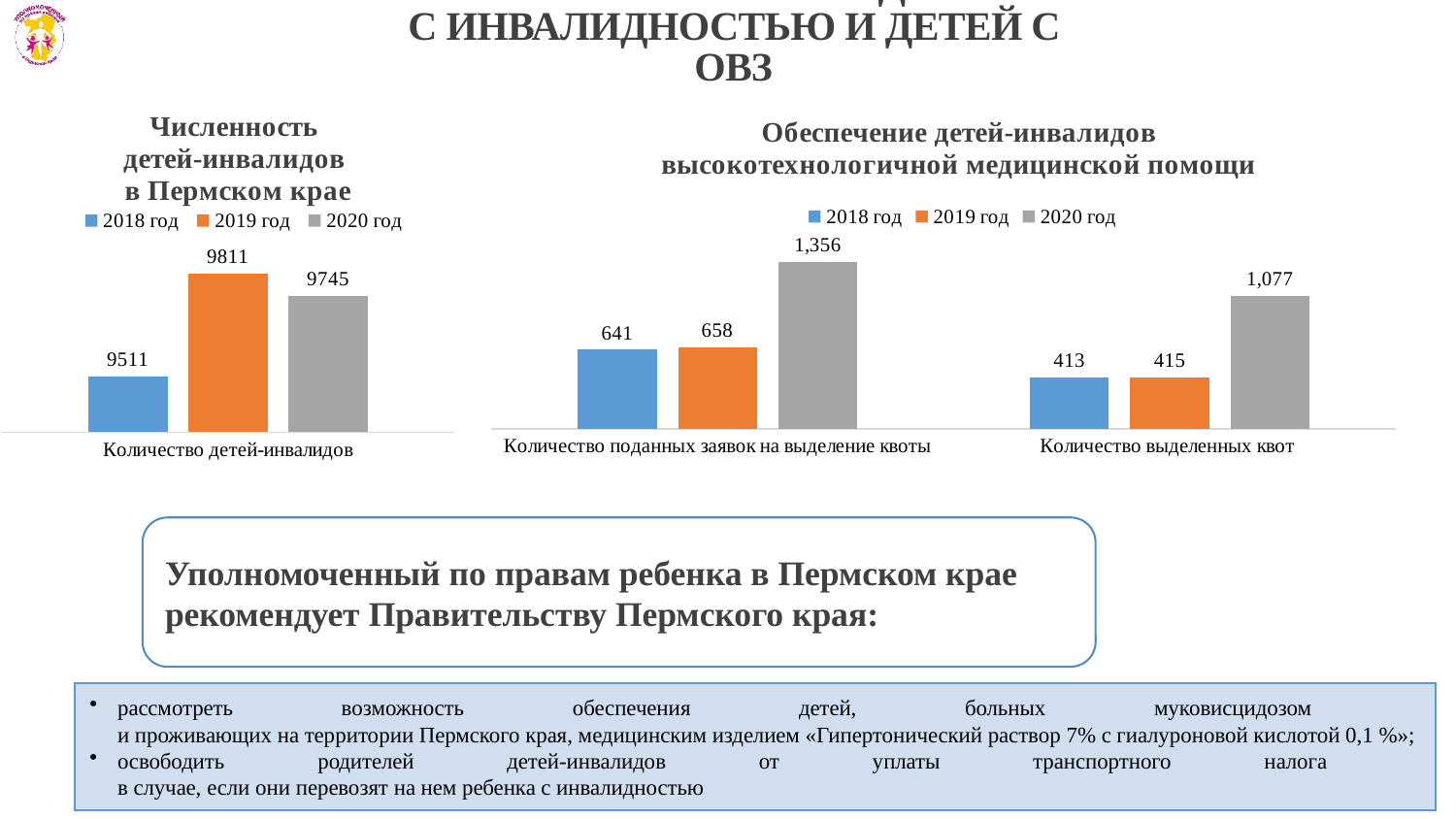
In the chart 'Численность детей-инвалидов в Пермском крае', what is the difference between the 2019 год and 2018 год values? 300 In the chart 'Обеспечение детей-инвалидов высокотехнологичной медицинской помощи', which is larger: the 2019 год value for 'Количество поданных заявок на выделение квоты' or the 2020 год value for 'Количество выделенных квот'? 2020 год value for 'Количество выделенных квот' In the chart 'Обеспечение детей-инвалидов высокотехнологичной медицинской помощи', what is the value for 2018 год in 'Количество выделенных квот'? 413 In the chart 'Обеспечение детей-инвалидов высокотехнологичной медицинской помощи', how many categories are shown on the x axis? 2 In the chart 'Численность детей-инвалидов в Пермском крае', which year has the lowest value? 2018 год What kind of chart is 'Обеспечение детей-инвалидов высокотехнологичной медицинской помощи'? Bar chart In the chart 'Обеспечение детей-инвалидов высокотехнологичной медицинской помощи', which year has the highest value for 'Количество выделенных квот'? 2020 год In the chart 'Обеспечение детей-инвалидов высокотехнологичной медицинской помощи', what is the value for 2020 год in 'Количество поданных заявок на выделение квоты'? 1,356 In the chart 'Обеспечение детей-инвалидов высокотехнологичной медицинской помощи', what is the difference between the 2020 год values for 'Количество поданных заявок на выделение квоты' and 'Количество выделенных квот'? 279 In the chart 'Численность детей-инвалидов в Пермском крае', how many series does the legend list? 3 In the chart 'Численность детей-инвалидов в Пермском крае', what is the value for 2019 год? 9811 In the chart 'Обеспечение детей-инвалидов высокотехнологичной медицинской помощи', which colour represents 2020 год? Grey